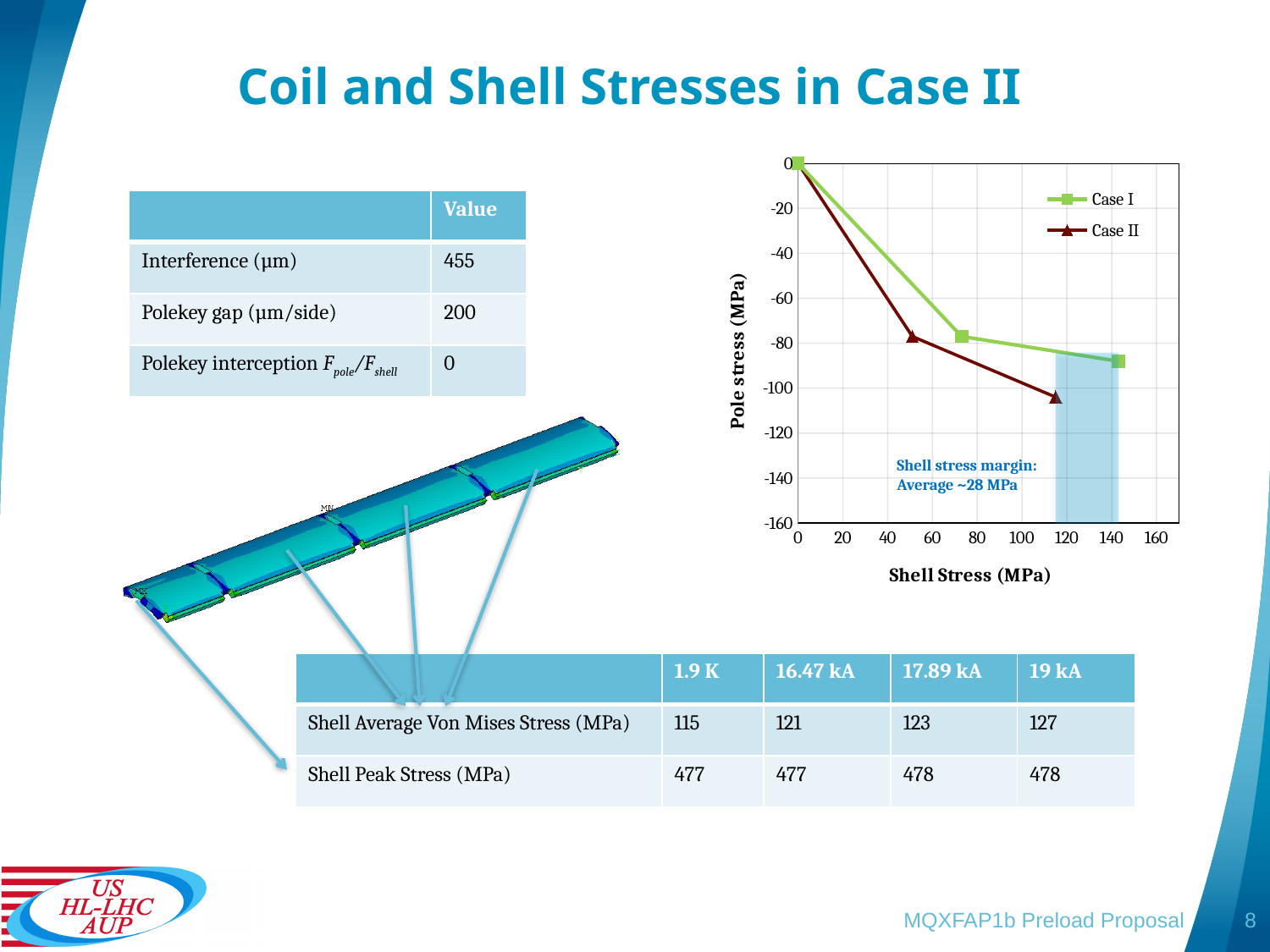
What shell stress margin does the annotation inside the chart state? Average ~28 MPa Is the shell stress at the final Case II point greater or less than 100? greater What kind of chart is shown on the slide? line chart How many data points are plotted for the Case II series? 3 As shell stress increases along the x axis, does the pole stress for Case I rise or fall? fall How many series does the chart's legend list? 2 Which series reaches the higher shell stress at its final point, Case I or Case II? Case I What are the two series named in the chart's legend? Case I and Case II At their final points, which series reaches the more negative pole stress, Case I or Case II? Case II Does the final Case II point lie above or below the -100 line on the pole stress axis? below Is the shell stress at the middle Case II point greater or less than 60? less